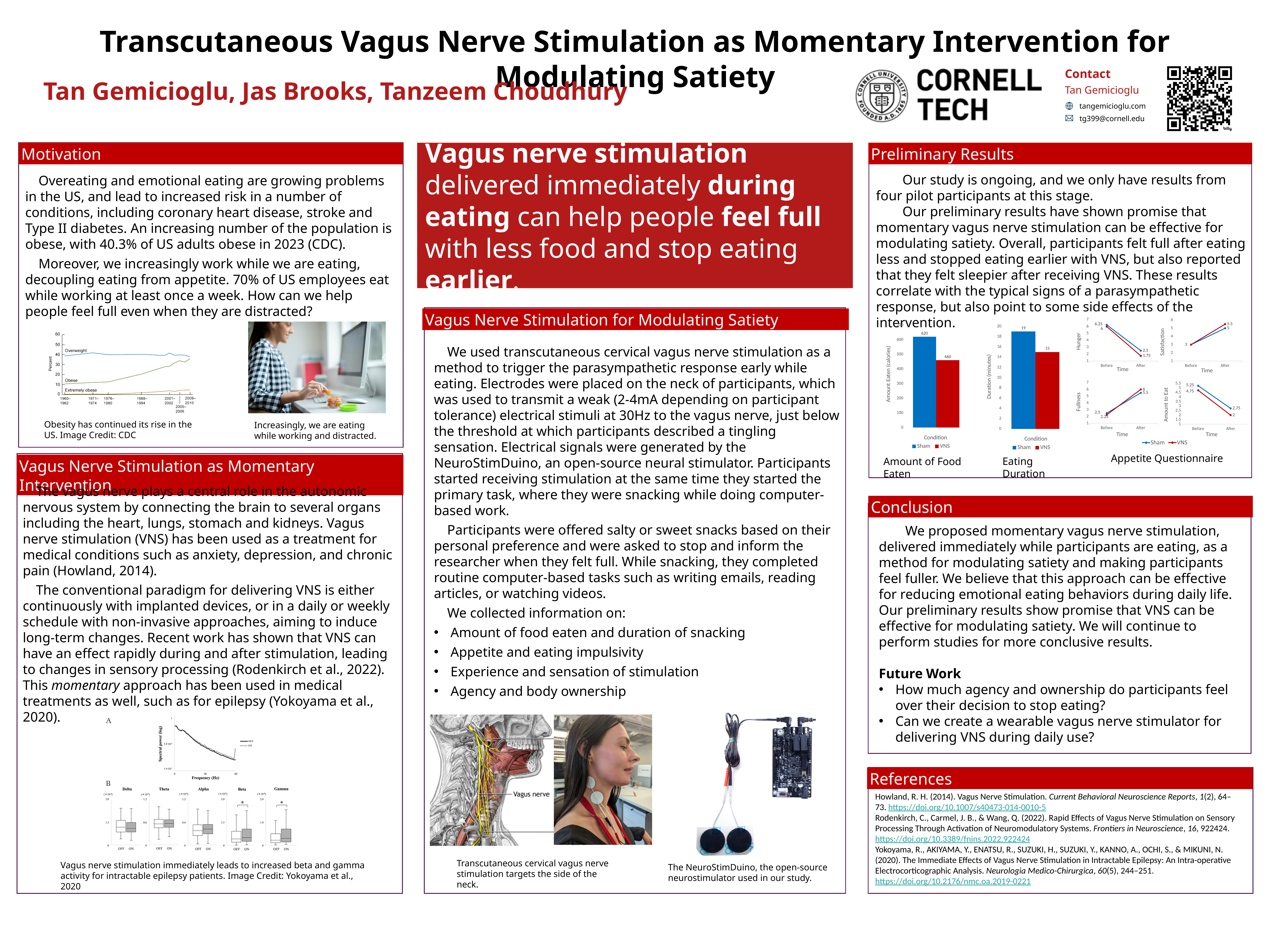
In the Eating Duration chart, which condition has the lower value? VNS In the Amount of Food Eaten chart, what is the value for the VNS condition? 460 In the Appetite Questionnaire Fullness chart, what is the Sham value after eating? 5.5 In the Amount of Food Eaten chart, what is the value for the Sham condition? 620 What kind of chart is the Amount of Food Eaten chart? Bar chart In the Amount of Food Eaten chart, what is the difference between the Sham and VNS values? 160 In the Amount of Food Eaten chart, which colour represents the VNS condition? Red In the Eating Duration chart, what is the duration in minutes for the Sham condition? 19 In the Eating Duration chart, how many series does the legend list? 2 In the Eating Duration chart, what is the duration in minutes for the VNS condition? 15 In the Appetite Questionnaire Hunger chart, do the values rise or fall from Before to After? Fall In the Appetite Questionnaire Hunger chart, what is the Sham value after eating? 2.5